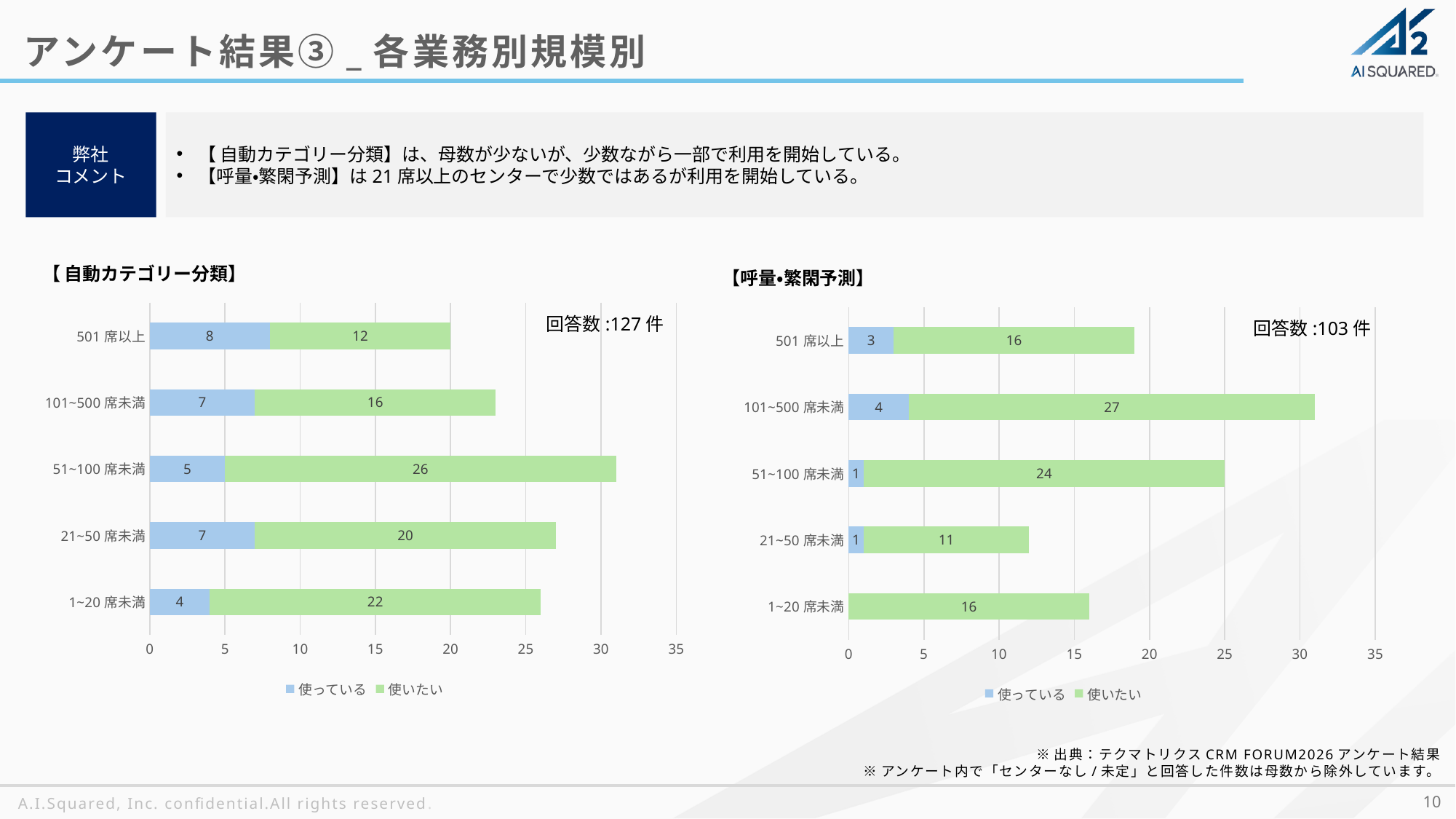
In the 【自動カテゴリー分類】 chart, what is the 使いたい value for 51~100席未満? 26 In the 【呼量・繁閑予測】 chart, is the 使いたい value larger for 501席以上 or for 21~50席未満? 501席以上 In the 【呼量・繁閑予測】 chart, what is the 使っている value for 501席以上? 3 In the 【自動カテゴリー分類】 chart, what is the difference between the 使いたい and 使っている values for 1~20席未満? 18 In the 【呼量・繁閑予測】 chart, what is the 使いたい value for 101~500席未満? 27 In the 【自動カテゴリー分類】 chart, what is the 使っている value for 501席以上? 8 In the 【呼量・繁閑予測】 chart, what is the total of the stacked bar for 51~100席未満? 25 How many categories are shown on the y axis of the 【自動カテゴリー分類】 chart? 5 In the 【呼量・繁閑予測】 chart, which category has the lowest 使いたい value? 21~50席未満 How many series does the legend of the 【呼量・繁閑予測】 chart list? 2 In the 【自動カテゴリー分類】 chart, which category has the highest 使いたい value? 51~100席未満 In the 【自動カテゴリー分類】 chart, what is the total of the stacked bar for 21~50席未満? 27